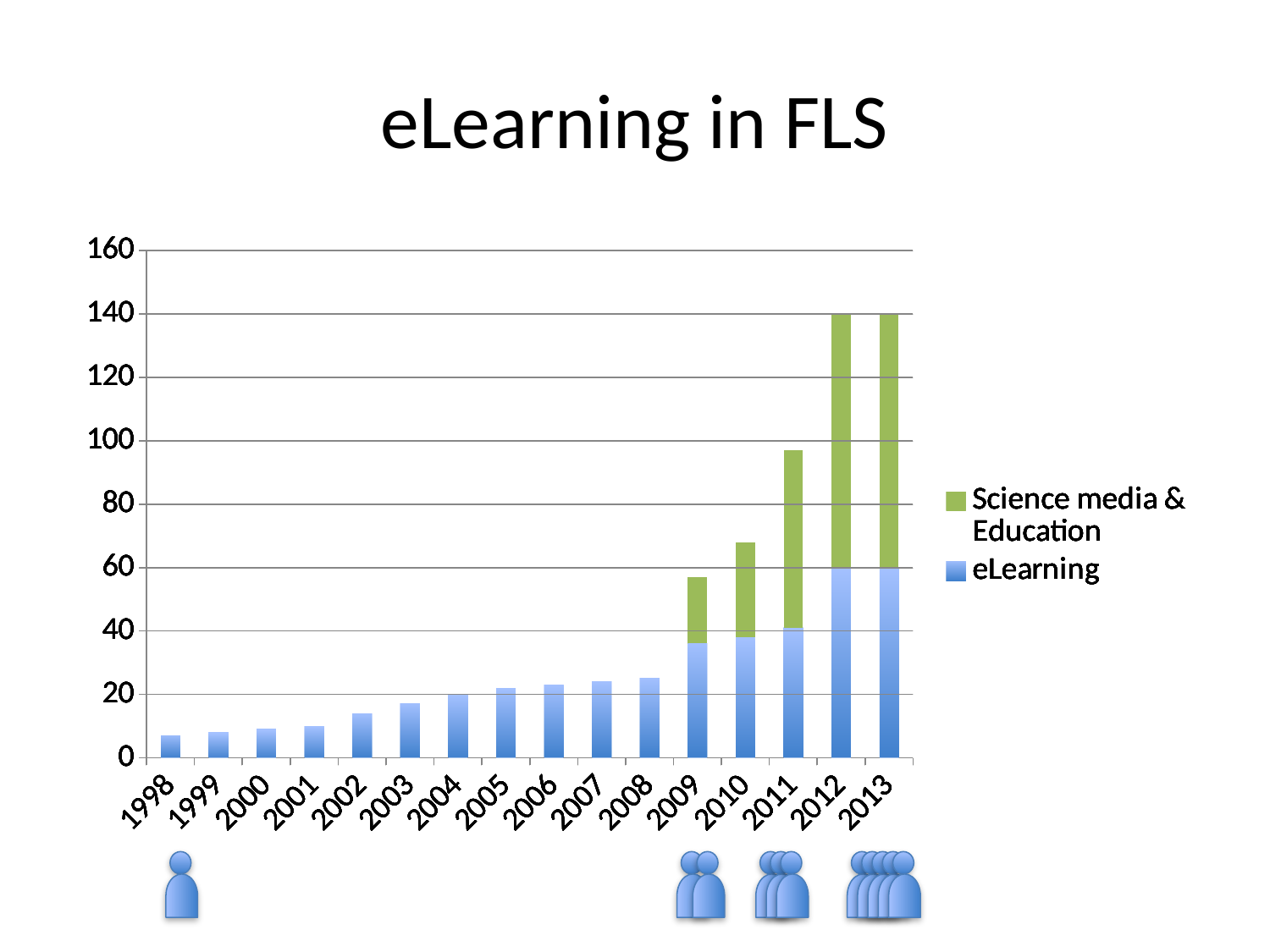
Do the eLearning values generally rise or fall from 1998 to 2013? rise How many years are shown on the x axis? 16 What is the title of the chart? eLearning in FLS Is the total value for 2011 greater or less than 80? greater Is the eLearning value for 2001 greater or less than 20? less Which is larger, the total bar for 2010 or the total bar for 2011? 2011 Which series is shown in green in the legend? Science media & Education What kind of chart is shown on the slide? Stacked bar chart Which year has the lowest total bar? 1998 Is the eLearning value for 2008 greater or less than 40? less How many series does the legend list? 2